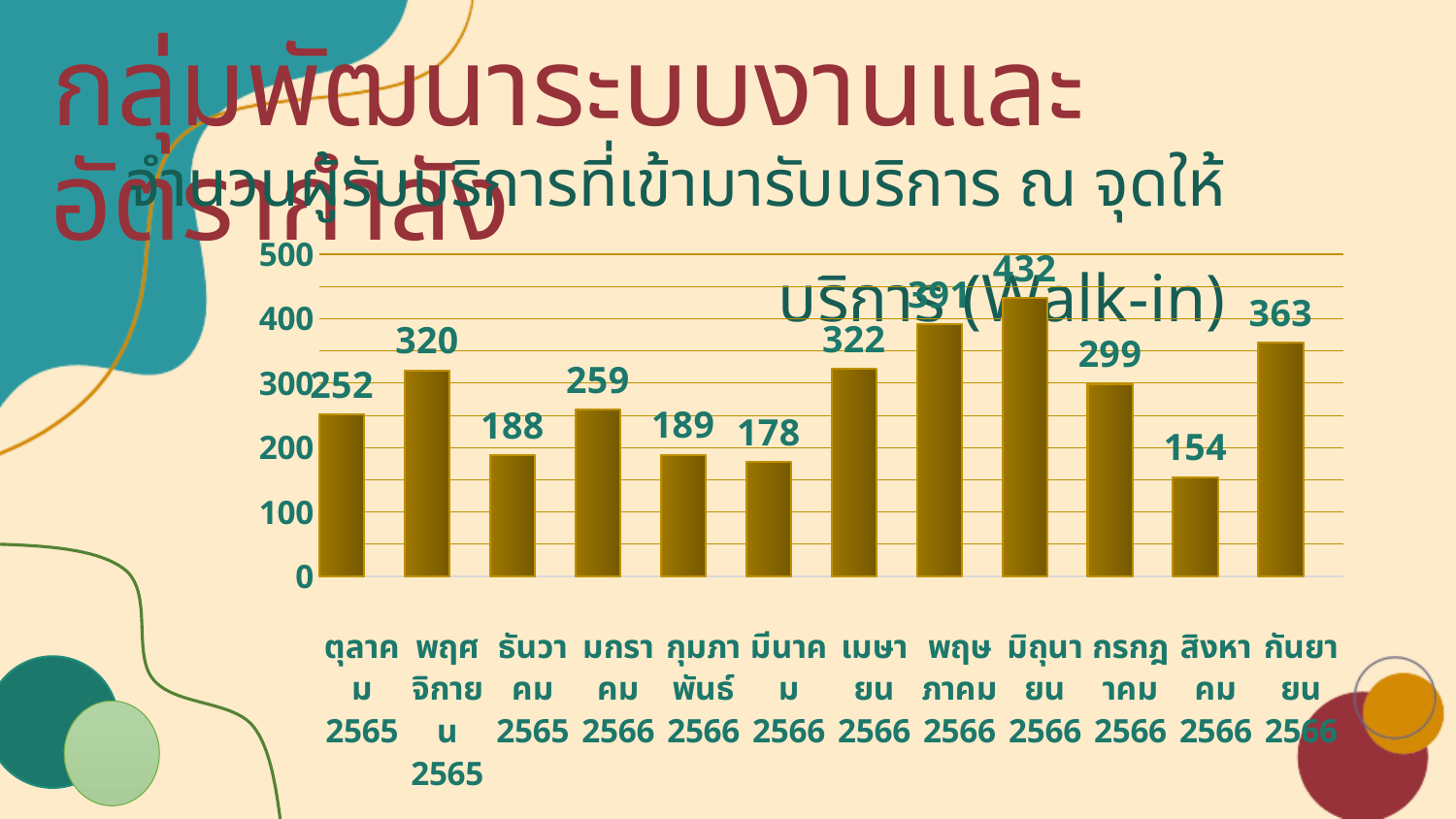
What is the value for ตุลาคม 2565? 252 How many months are shown on the x axis? 12 Do the values rise or fall from มิถุนายน 2566 to สิงหาคม 2566? fall What is the difference between the values for พฤศจิกายน 2565 and ธันวาคม 2565? 132 Which month has the lowest value? สิงหาคม 2566 Is the value for เมษายน 2566 greater or less than 300? greater What is the value for มิถุนายน 2566? 432 What is the value for กันยายน 2566? 363 What is the value for สิงหาคม 2566? 154 What kind of chart is shown on the slide? bar chart Which is larger, the value for มกราคม 2566 or the value for กุมภาพันธ์ 2566? มกราคม 2566 Which month has the highest value? มิถุนายน 2566